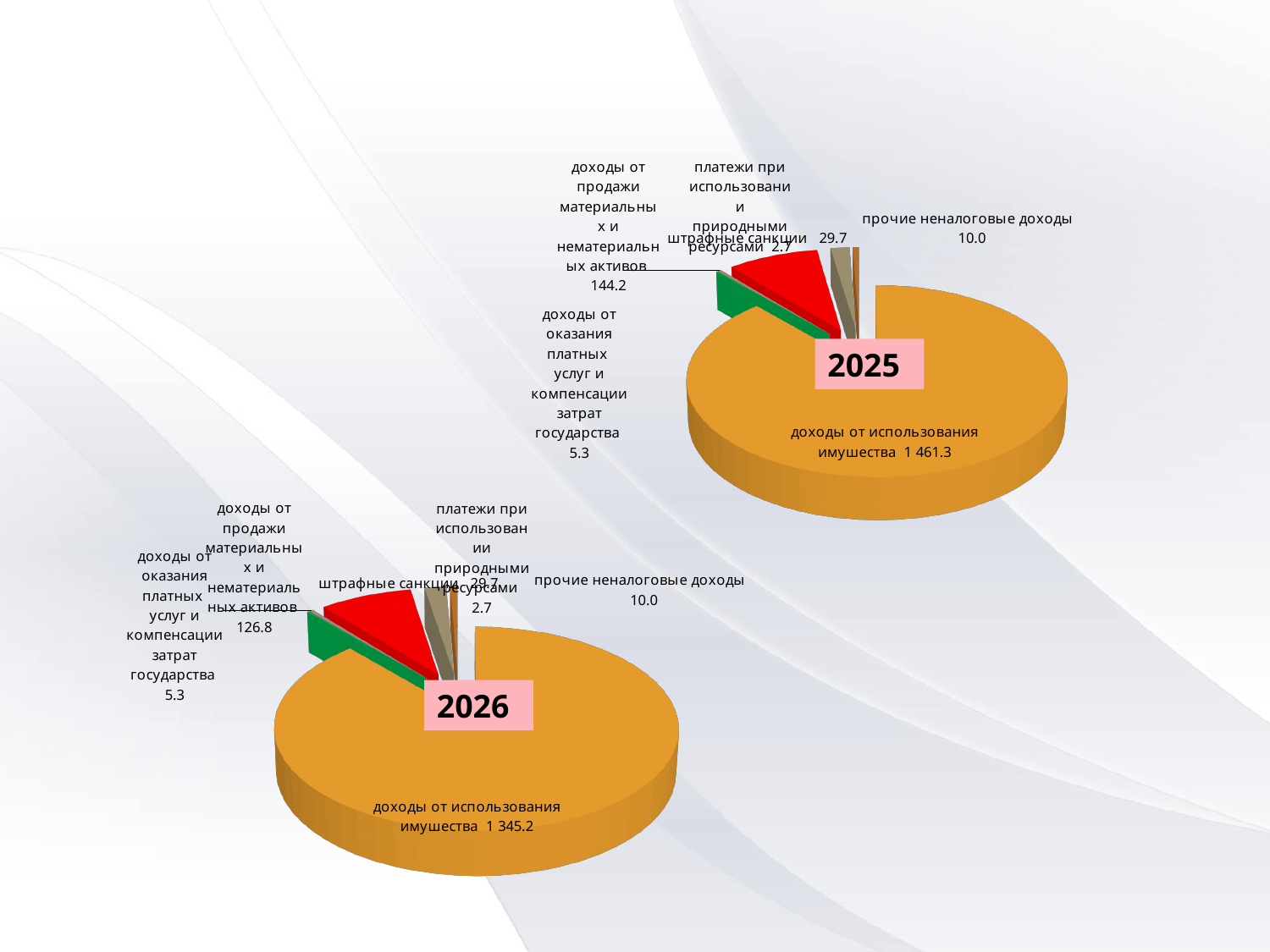
In the 2025 pie chart, what is the value for доходы от использования имущества? 1 461.3 In the 2025 pie chart, which category has the largest value? доходы от использования имущества In the 2026 pie chart, what is the value for доходы от продажи материальных и нематериальных активов? 126.8 In the 2026 pie chart, what is the value for доходы от использования имущества? 1 345.2 How many categories does the 2026 pie chart show? 6 What type of chart is used for the 2025 data? pie chart What is the difference between доходы от продажи материальных и нематериальных активов in the 2025 chart and in the 2026 chart? 17.4 What is the difference between доходы от использования имущества in the 2025 chart and in the 2026 chart? 116.1 In the 2026 pie chart, which category has the smallest value? платежи при использовании природными ресурсами In the 2025 pie chart, what is the value for доходы от продажи материальных и нематериальных активов? 144.2 In the 2026 pie chart, what is the value for штрафные санкции? 29.7 In the 2025 pie chart, which is larger: штрафные санкции or прочие неналоговые доходы? штрафные санкции